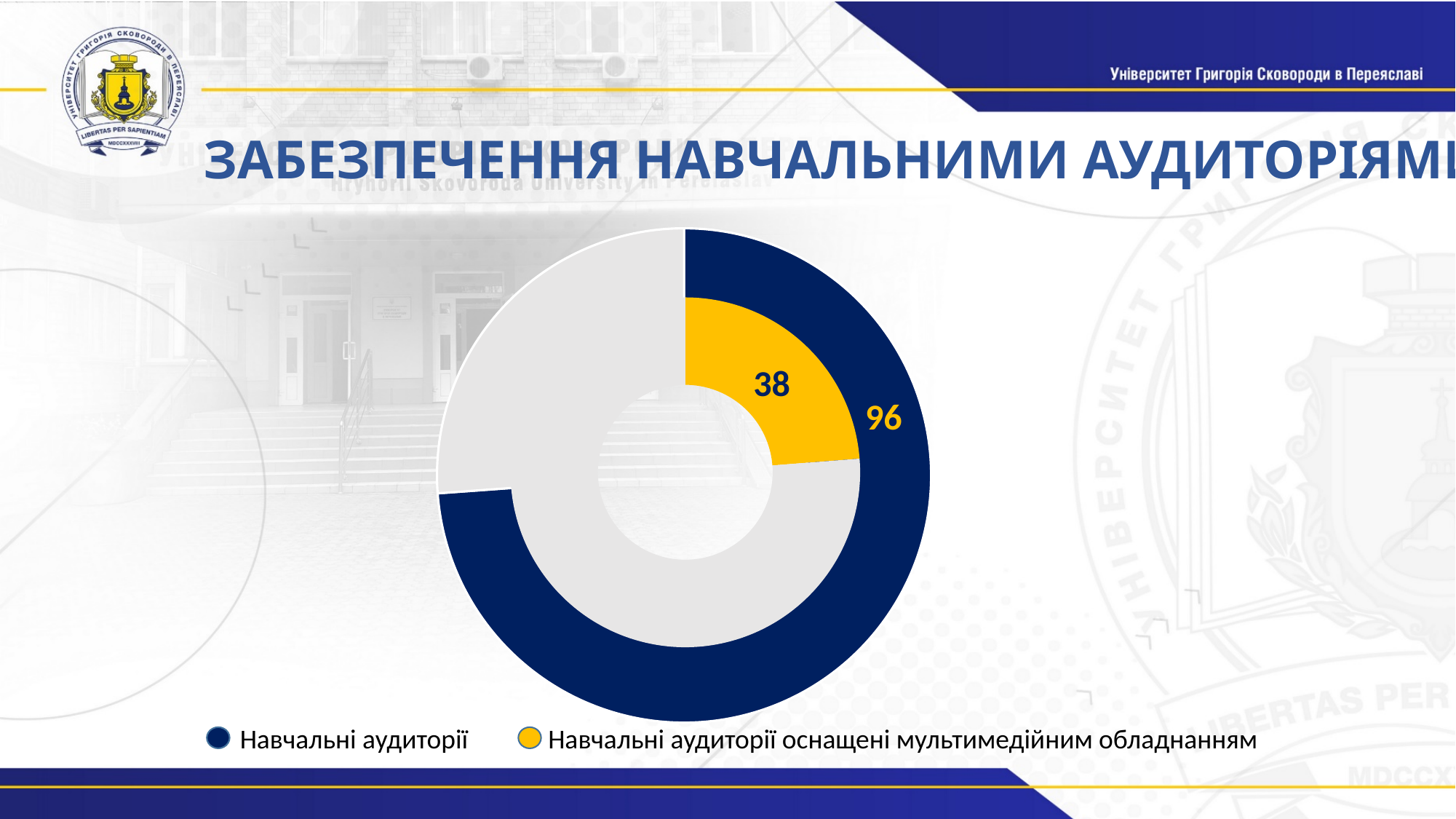
What value is shown for "Навчальні аудиторії"? 96 What value is shown for "Навчальні аудиторії оснащені мультимедійним обладнанням"? 38 Which of the two legend entries has the larger value? Навчальні аудиторії Is the value for "Навчальні аудиторії" larger or smaller than the value for "Навчальні аудиторії оснащені мультимедійним обладнанням"? larger What is the difference between the value for "Навчальні аудиторії" and the value for "Навчальні аудиторії оснащені мультимедійним обладнанням"? 58 What colour represents "Навчальні аудиторії оснащені мультимедійним обладнанням" in the chart? yellow What kind of chart is shown on the slide? doughnut chart How many data values are labelled on the chart? 2 Which of the two legend entries has the smaller value? Навчальні аудиторії оснащені мультимедійним обладнанням How many entries does the legend list? 2 What is the title of the slide containing the chart? ЗАБЕЗПЕЧЕННЯ НАВЧАЛЬНИМИ АУДИТОРІЯМИ